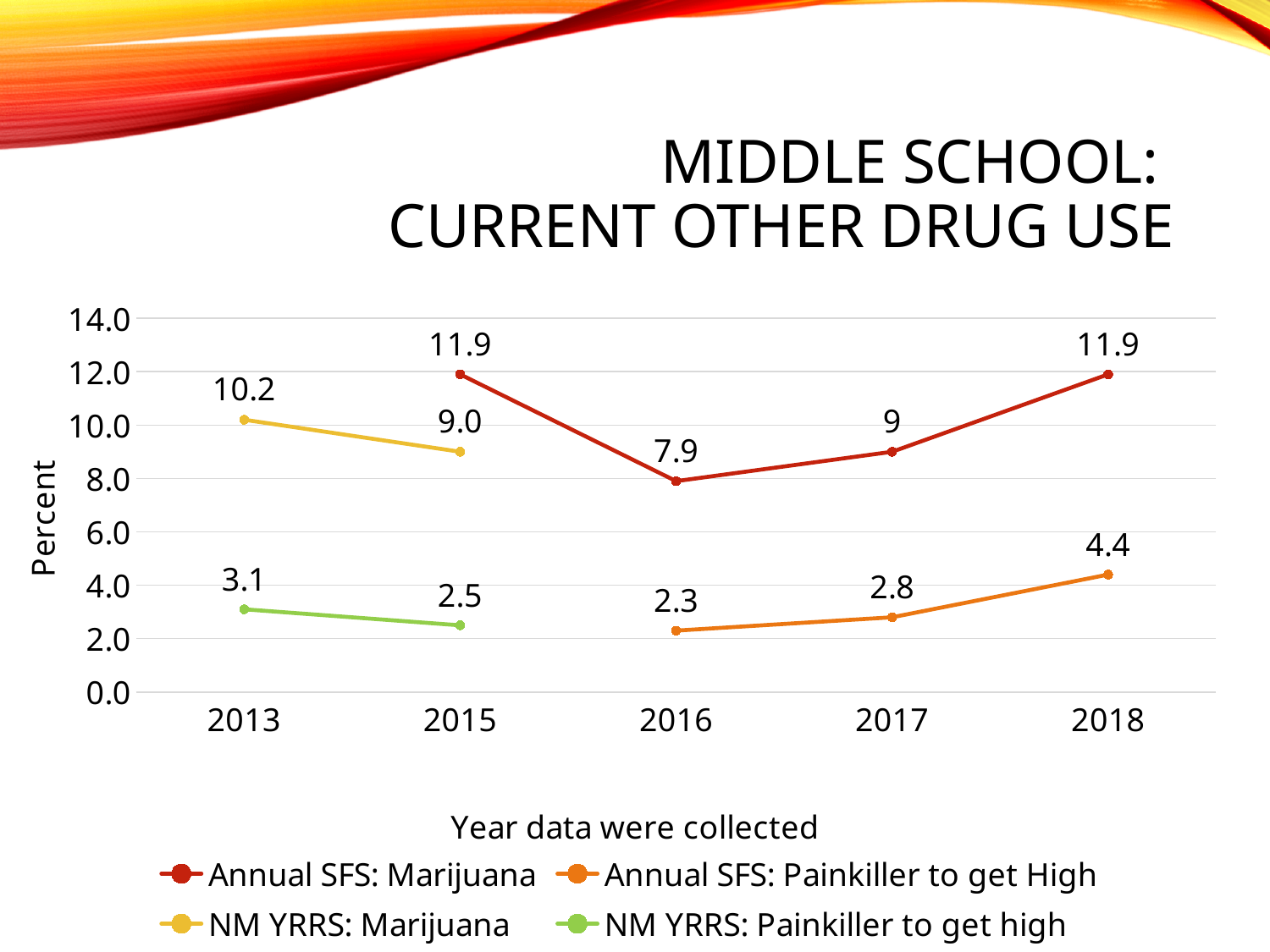
What is the difference between the Annual SFS: Marijuana values in 2015 and 2016? 4.0 How many years are shown on the x axis? 5 Which is larger: NM YRRS: Marijuana in 2015 or Annual SFS: Marijuana in 2017? Neither; they are equal (9.0 and 9) What is the value for NM YRRS: Marijuana in 2013? 10.2 How many series does the legend list? 4 What is the label of the y axis? Percent Does the Annual SFS: Painkiller to get High series rise or fall from 2016 to 2018? Rise What is the value for Annual SFS: Painkiller to get High in 2018? 4.4 What kind of chart is shown on the slide? Line chart In which year is the Annual SFS: Painkiller to get High series lowest? 2016 What is the value for NM YRRS: Painkiller to get high in 2015? 2.5 What is the value for Annual SFS: Marijuana in 2016? 7.9